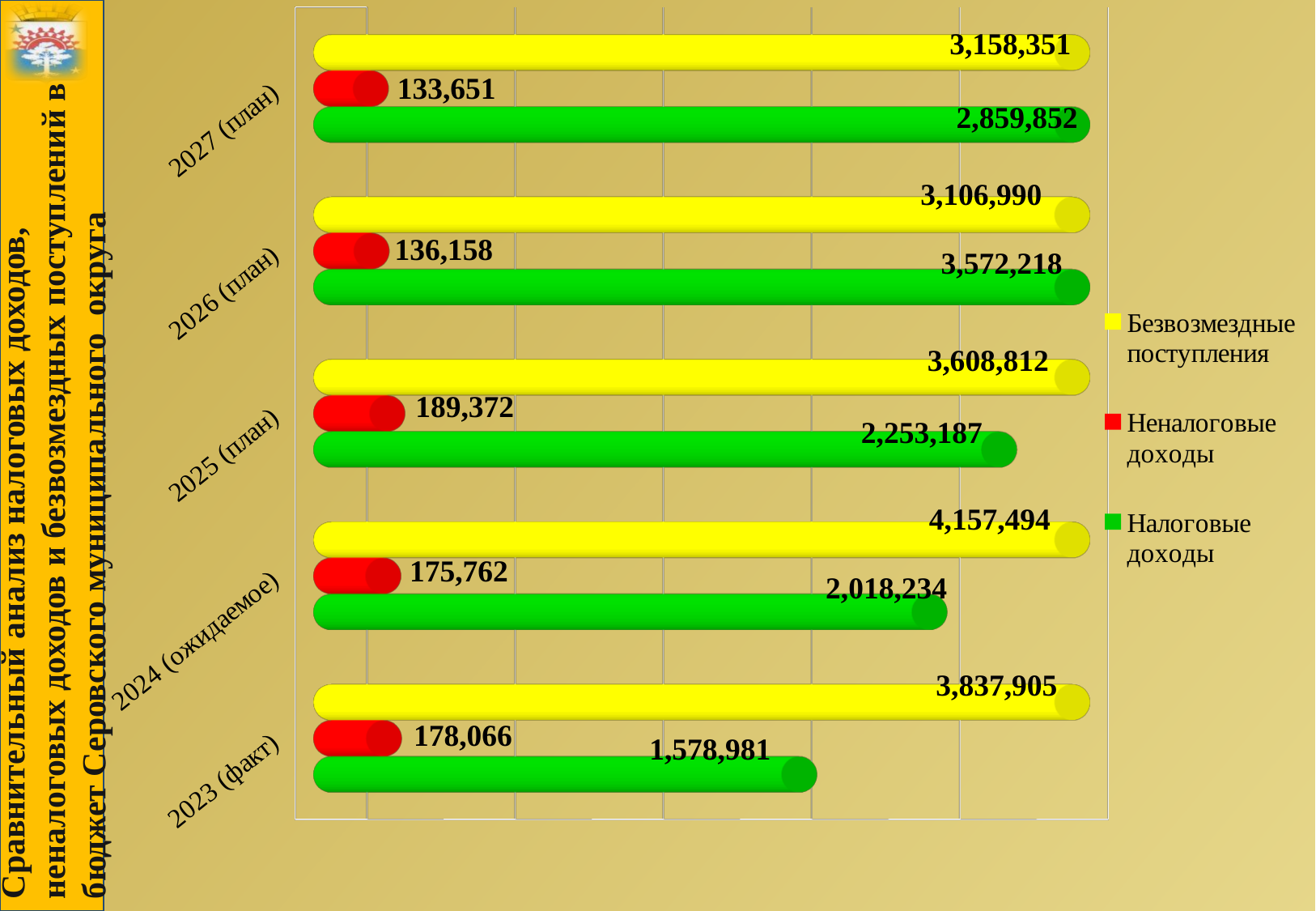
What is the value of Безвозмездные поступления for 2024 (ожидаемое)? 4,157,494 Which is larger for 2027 (план): Безвозмездные поступления or Налоговые доходы? Безвозмездные поступления What is the value of Неналоговые доходы for 2025 (план)? 189,372 What is the value of Налоговые доходы for 2023 (факт)? 1,578,981 In which year is Налоговые доходы the highest? 2026 (план) In which year is Неналоговые доходы the lowest? 2027 (план) What is the value of Налоговые доходы for 2026 (план)? 3,572,218 What type of chart is shown on the slide? bar chart How many series does the legend list? 3 What is the difference between Налоговые доходы in 2024 (ожидаемое) and 2023 (факт)? 439,253 Which colour represents Неналоговые доходы in the legend? red How many year categories are shown on the chart? 5